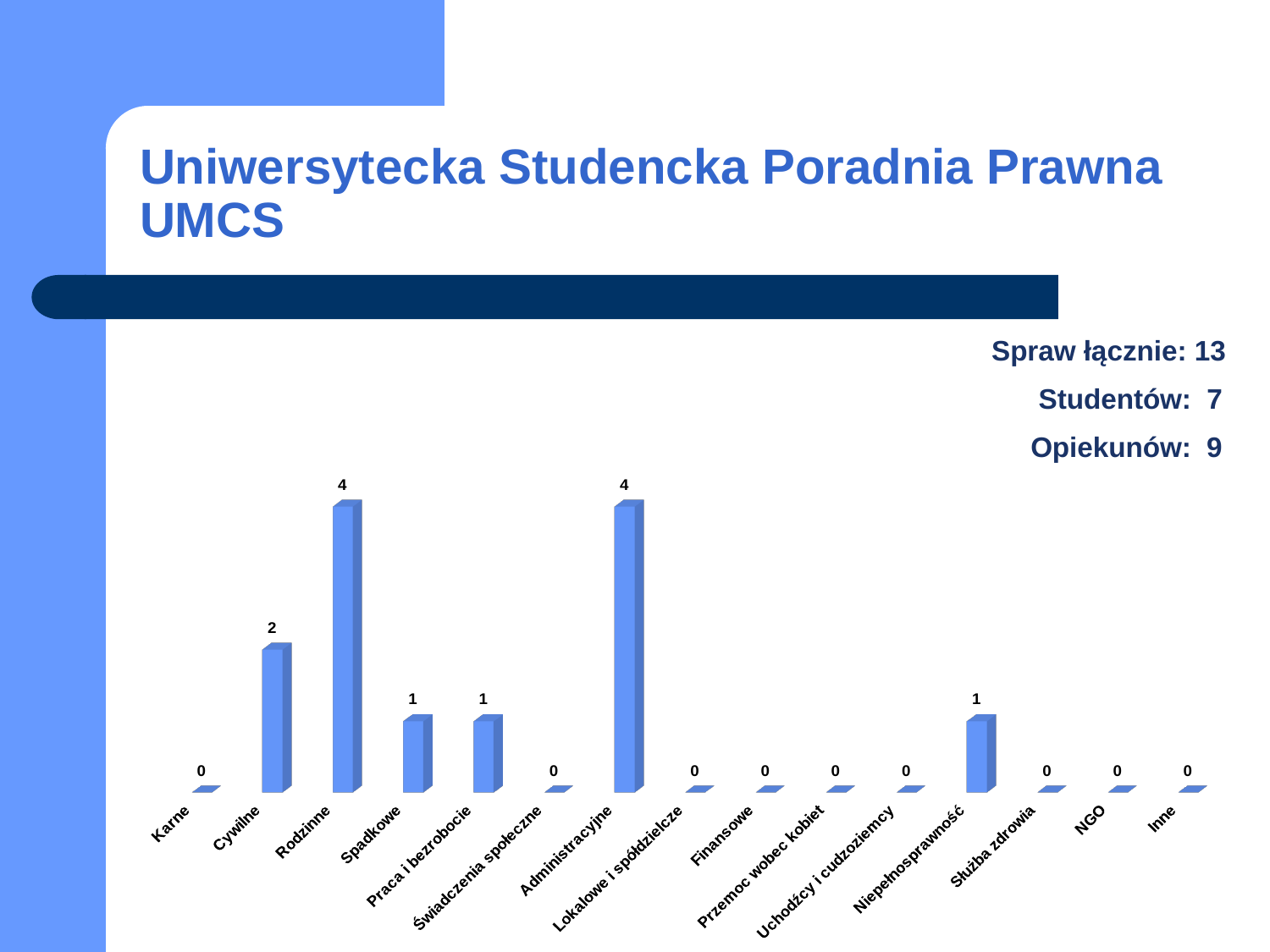
What is the difference between the values for Rodzinne and Cywilne? 2 Which is larger, the value for Cywilne or the value for Praca i bezrobocie? Cywilne What is the value for Cywilne? 2 What is the value for Niepełnosprawność? 1 Which two categories share the highest value in the chart? Rodzinne and Administracyjne What is the value for Spadkowe? 1 How many categories in the chart have a value of 0? 9 What is the value for Karne? 0 How many categories are shown on the x axis of the chart? 15 What kind of chart is shown on the slide? bar chart What is the value for Administracyjne? 4 What is the value for Rodzinne? 4